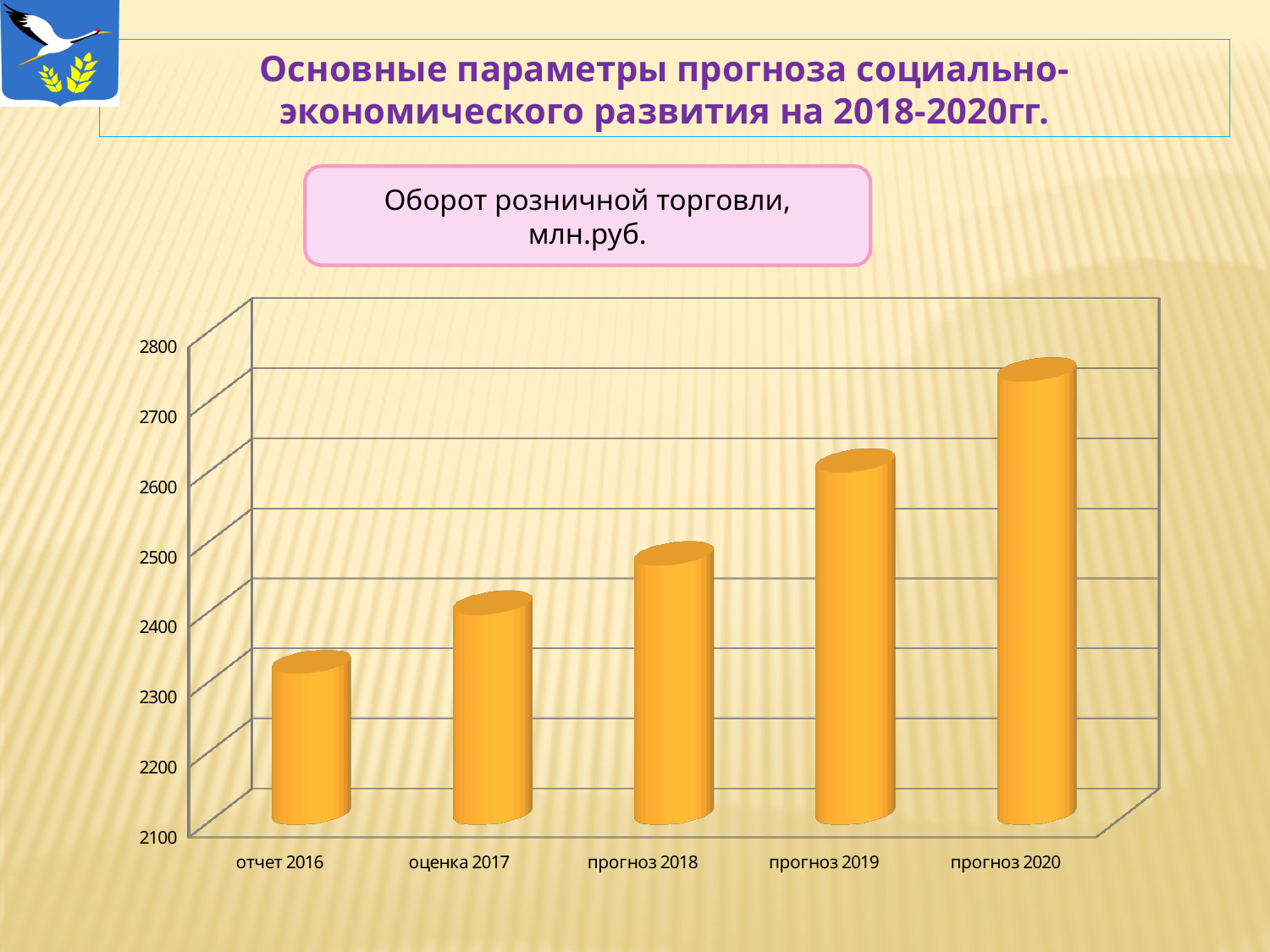
Is the value for прогноз 2020 greater or less than 2600? greater Which category has the highest value in the chart? прогноз 2020 Is the value for прогноз 2018 greater or less than 2600? less Do the values rise or fall from отчет 2016 to прогноз 2020? rise Is the value for оценка 2017 greater or less than 2500? less Which category has the lowest value in the chart? отчет 2016 How many categories are shown on the x axis of the chart? 5 Which is larger, the value for прогноз 2019 or the value for оценка 2017? прогноз 2019 What is the title of the chart shown on the slide? Оборот розничной торговли, млн.руб. What kind of chart is shown on the slide? bar chart